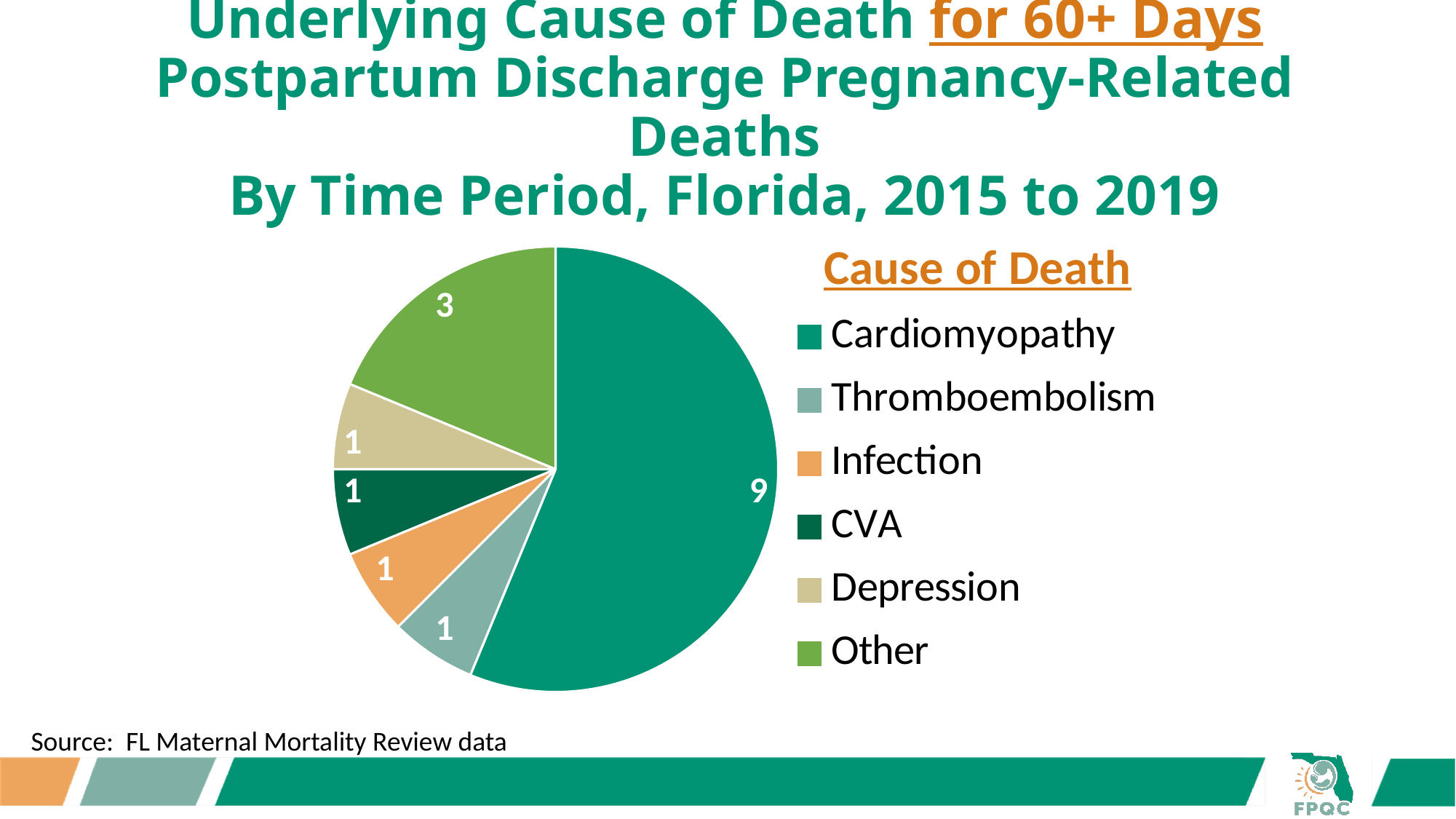
How many deaths are attributed to Cardiomyopathy? 9 What share of the total deaths does the Other category represent? 18.75% How many deaths are attributed to Thromboembolism? 1 What share of the total deaths does Cardiomyopathy represent? 56.25% What is the total number of deaths represented in the pie chart? 16 What type of chart is shown on the slide? Pie chart How many cause-of-death categories does the pie chart show? 6 What is the difference between the number of Cardiomyopathy deaths and Other deaths? 6 Which is larger, the number of deaths from Other causes or from Infection? Other How many deaths are attributed to Other causes? 3 What is the title of the legend on the slide? Cause of Death Which cause of death has the largest slice of the pie? Cardiomyopathy